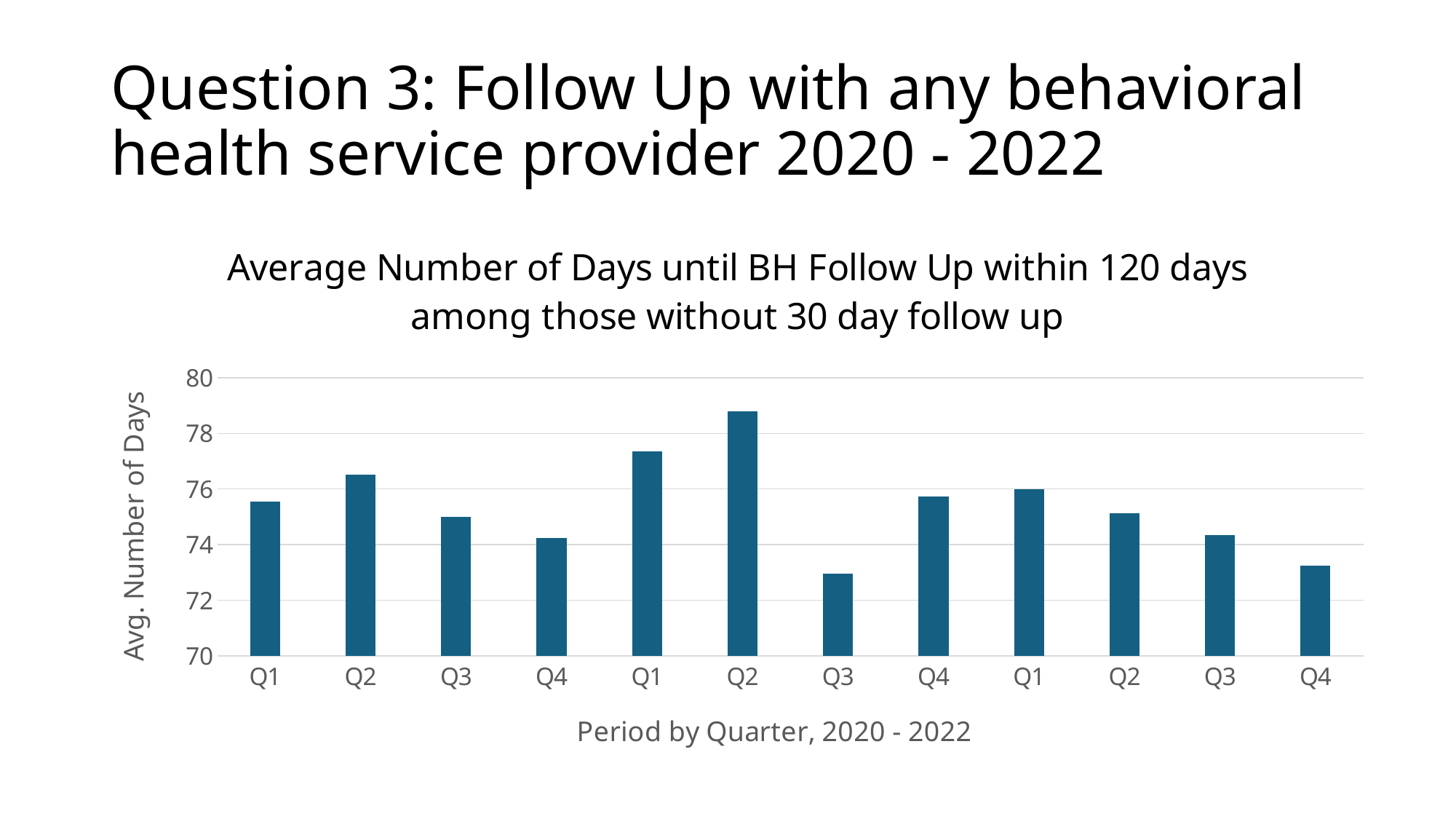
What is the label of the x axis? Period by Quarter, 2020 - 2022 Which bar is the highest in the chart? the sixth bar from the left (the second Q2) How many bars (quarters) are plotted in the chart? 12 What is the label of the y axis? Avg. Number of Days Which is larger: the fifth bar (the second Q1) or the ninth bar (the third Q1)? the fifth bar (the second Q1) What kind of chart is shown on the slide? bar chart Is the value for the seventh bar from the left (the second Q3) greater or less than 74? less Which bar is the lowest in the chart? the seventh bar from the left (the second Q3) Which is larger: the second bar (the first Q2) or the third bar (the first Q3)? the second bar (the first Q2) Is the value for the first bar (the first Q1) greater or less than 74? greater Is the value for the last bar (the third Q4) greater or less than 74? less